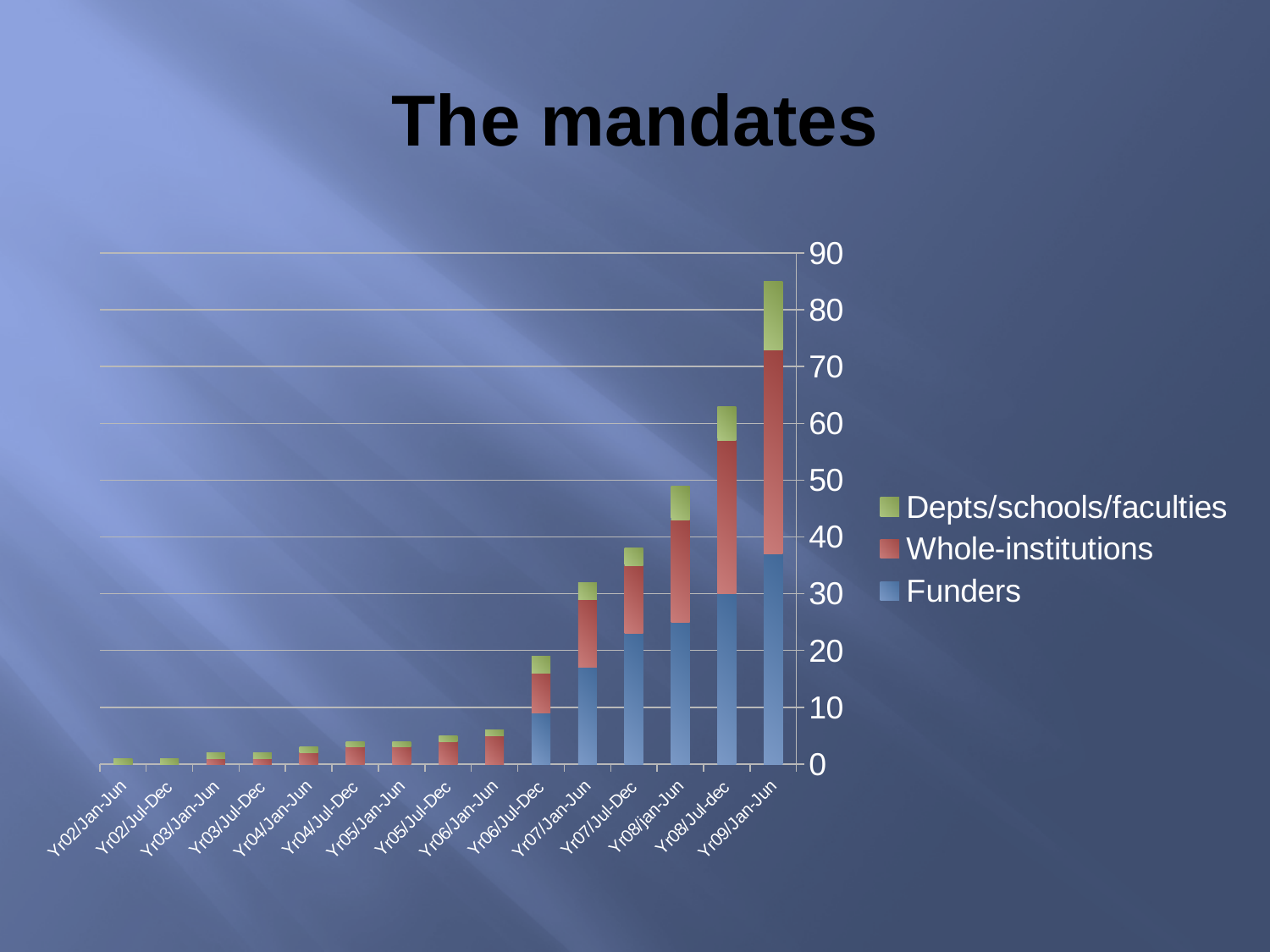
Is the total stacked value for Yr09/Jan-Jun greater or less than 80? greater Do the total stacked values generally rise or fall from Yr02/Jan-Jun to Yr09/Jan-Jun? Rise How many series does the legend list? 3 Which period has the tallest stacked bar? Yr09/Jan-Jun Is the total stacked value for Yr08/Jul-dec greater or less than 60? greater Which has the larger total stacked bar, Yr08/Jul-dec or Yr07/Jul-Dec? Yr08/Jul-dec Which series is shown in green in the legend? Depts/schools/faculties Is the Funders value for Yr09/Jan-Jun greater or less than 30? greater How many time periods (categories) are shown on the x axis? 15 What is the title of the chart? The mandates What kind of chart is shown on the slide? Stacked bar chart